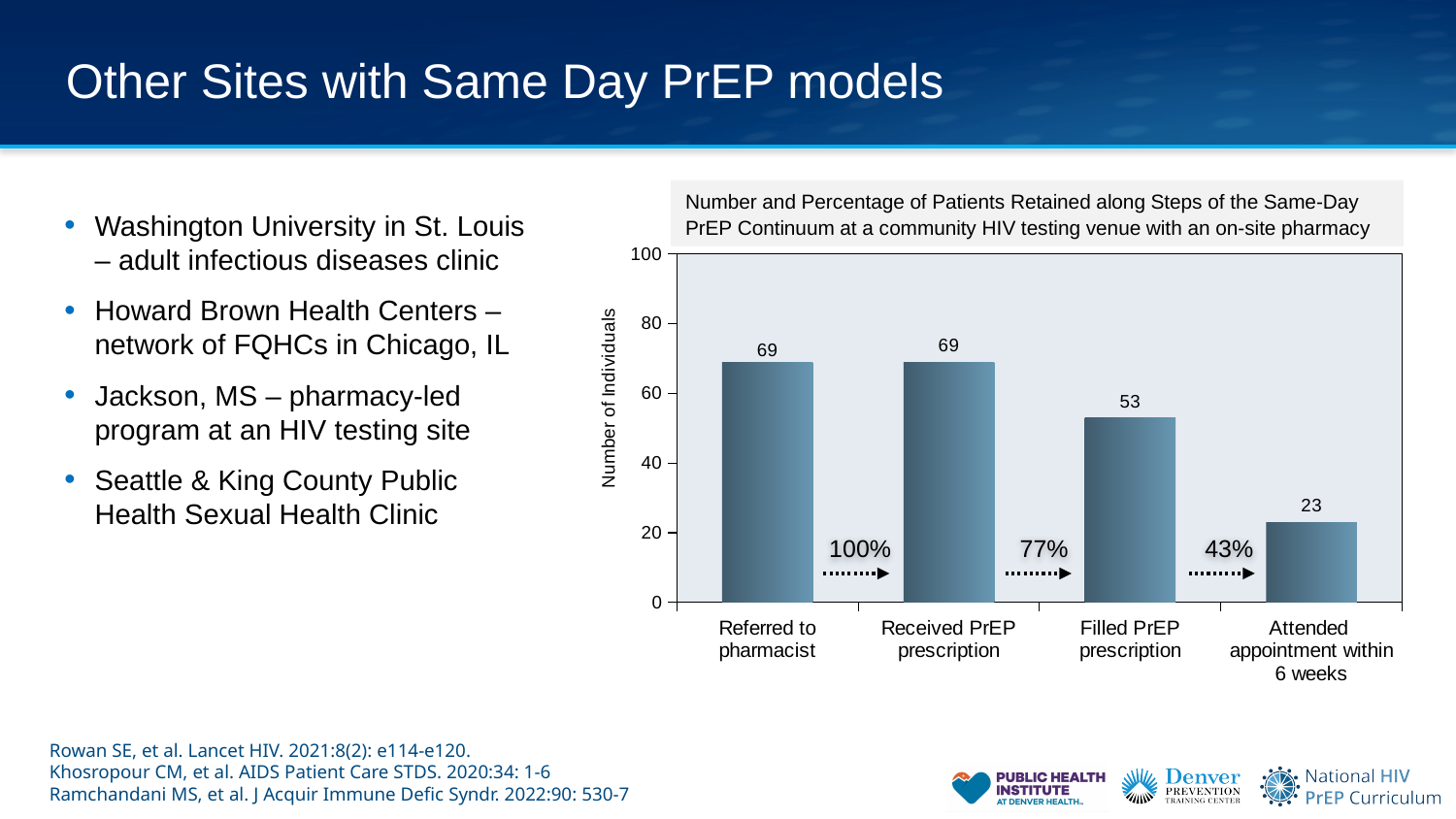
How many individuals were referred to the pharmacist? 69 What kind of chart is shown on the slide? Bar chart What percentage is shown between the Received PrEP prescription and Filled PrEP prescription steps? 77% How many individuals attended an appointment within 6 weeks? 23 What is the difference between the number who filled a PrEP prescription and the number who attended an appointment within 6 weeks? 30 How many steps (categories) are shown on the x axis? 4 Is the value for Filled PrEP prescription greater or less than 60? less What is the difference between the number who received a PrEP prescription and the number who filled a PrEP prescription? 16 How many individuals filled a PrEP prescription? 53 Do the values rise or fall moving from left to right along the x axis? Fall Which is larger: the number who filled a PrEP prescription or the number who attended an appointment within 6 weeks? Filled PrEP prescription Which step has the lowest number of individuals? Attended appointment within 6 weeks